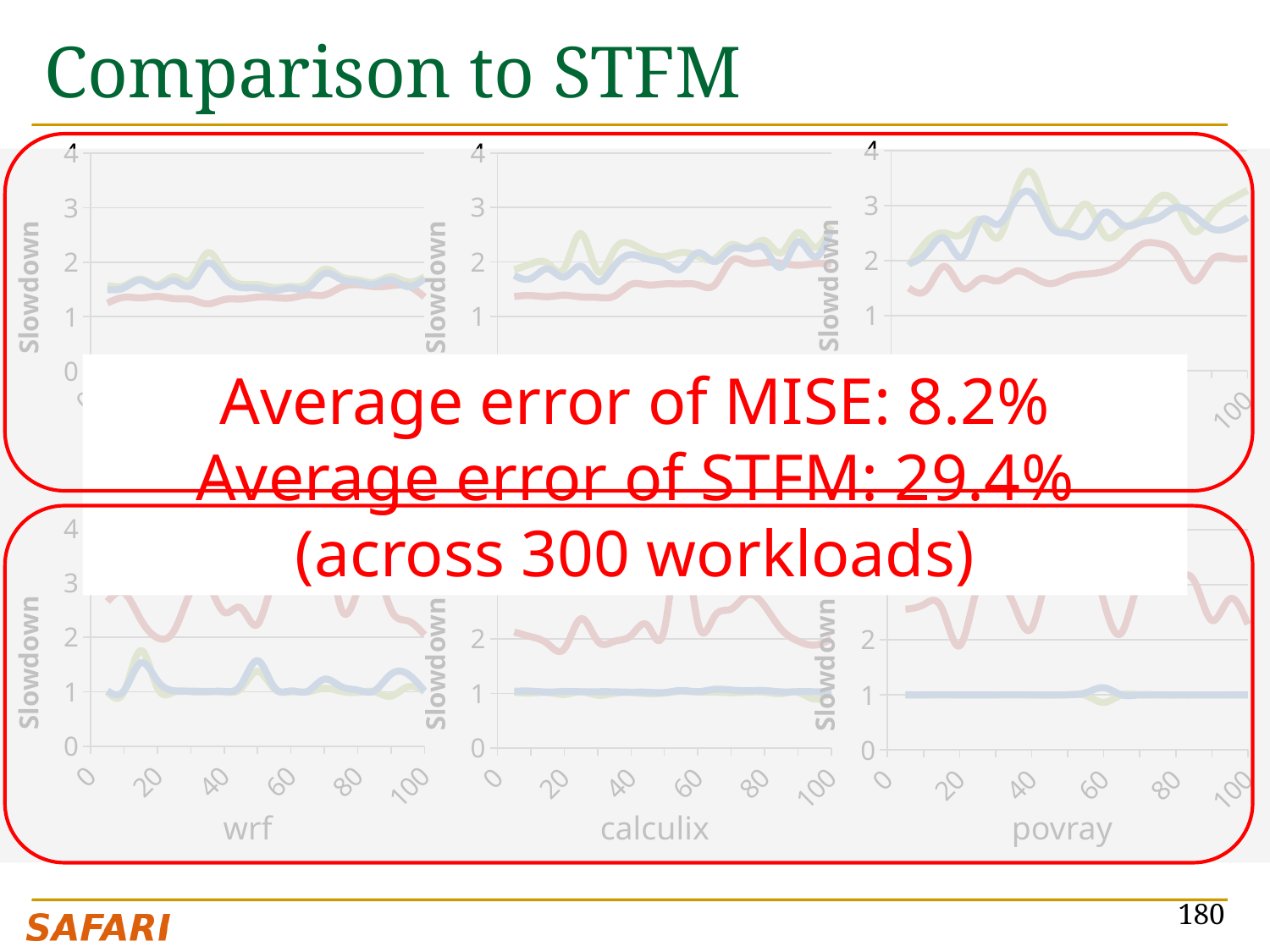
In the bottom-left chart (wrf), which line is higher at x = 40, the red line or the blue line? red line In the top-middle chart, does the red line generally rise or fall as x increases from 0 to 100? rise What kind of chart is used in each of the panels on this slide? line chart In the bottom-middle chart (calculix), is the value of the blue line at x = 60 greater or less than 2? less In the top-left chart, is the value of the red line at x = 40 greater or less than 2? less How many chart panels are shown on the slide? 6 In the bottom-right chart (povray), is the value of the blue line at x = 80 greater or less than 2? less What is the y-axis label on the charts? Slowdown In the top-right chart, does the blue line generally rise or fall as x increases from 0 to 100? rise What is the maximum value shown on the y-axis of the charts? 4